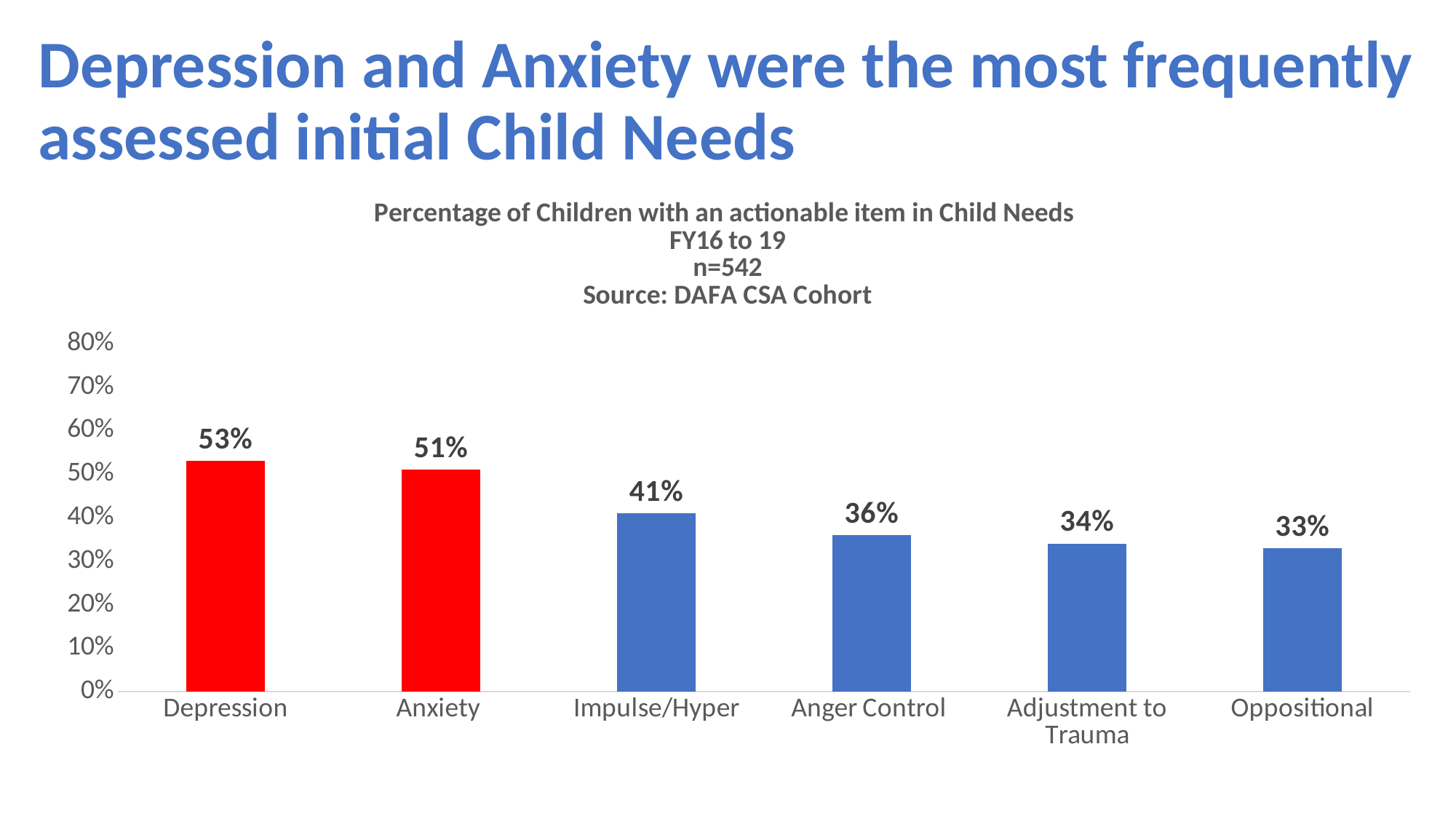
What kind of chart is shown on the slide? Bar chart Which category has the lowest percentage? Oppositional Do the values rise or fall moving from left to right along the x axis? Fall What is the difference between the Depression and Impulse/Hyper percentages? 12% What percentage is shown for Adjustment to Trauma? 34% What is the value shown for Anger Control? 36% Which two bars are coloured red? Depression and Anxiety What percentage of children had an actionable item for Depression? 53% What is the difference between the Anxiety and Oppositional percentages? 18% Which is larger, the value for Impulse/Hyper or the value for Anger Control? Impulse/Hyper How many categories are shown on the x axis? 6 Which category has the highest percentage? Depression